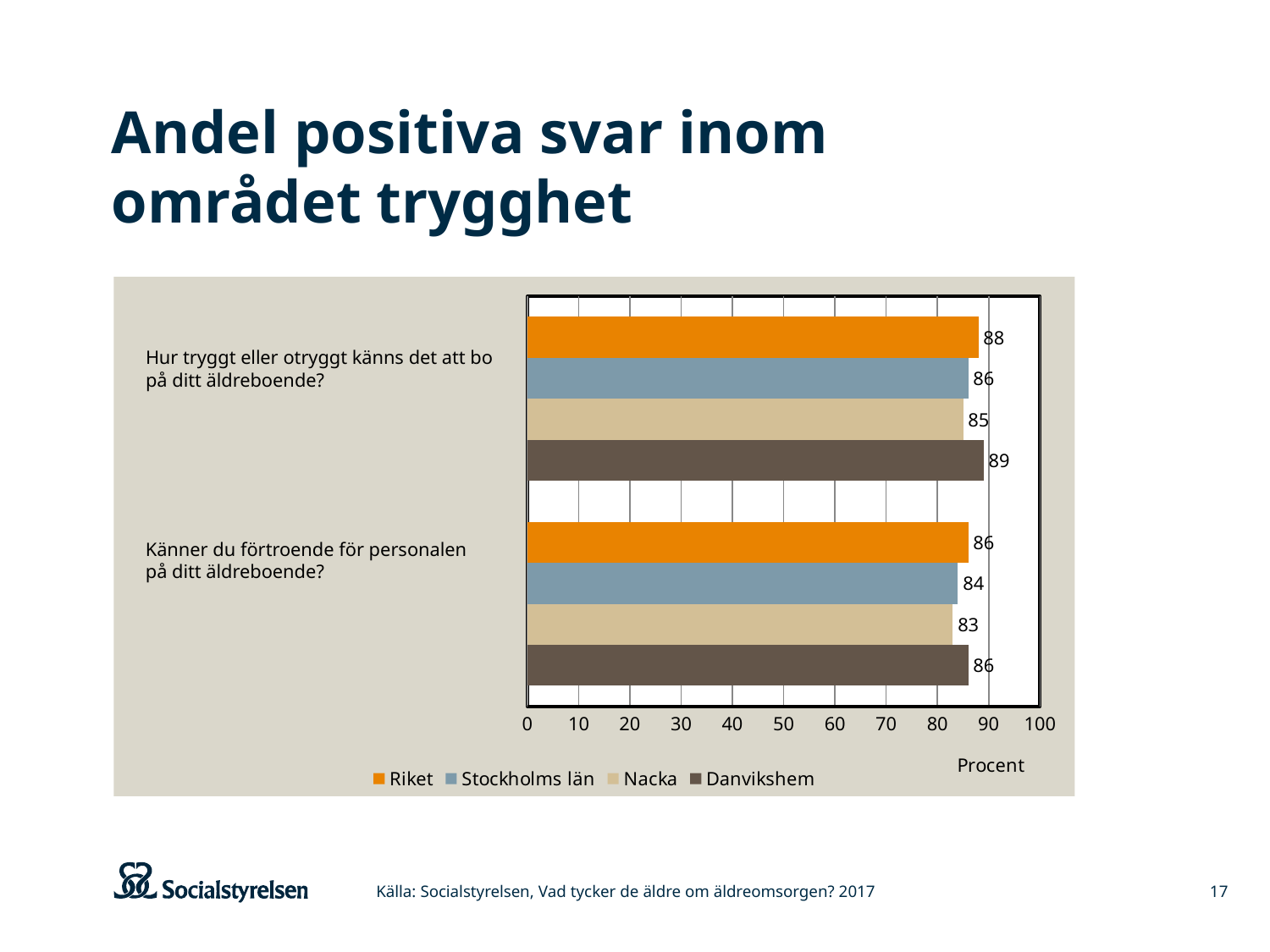
What kind of chart is shown on the slide? Bar chart What is the value for Danvikshem on the question "Känner du förtroende för personalen på ditt äldreboende?"? 86 Which is larger for "Känner du förtroende för personalen på ditt äldreboende?": Riket or Stockholms län? Riket What is the difference between the Danvikshem and Nacka values for "Hur tryggt eller otryggt känns det att bo på ditt äldreboende?"? 4 What unit is shown on the x axis of the chart? Procent What is the value for Nacka on the question "Känner du förtroende för personalen på ditt äldreboende?"? 83 How many series does the legend list? 4 Is the value for Stockholms län on "Känner du förtroende för personalen på ditt äldreboende?" greater or less than 90? less Which series has the lowest value for "Känner du förtroende för personalen på ditt äldreboende?"? Nacka Which series has the highest value for "Hur tryggt eller otryggt känns det att bo på ditt äldreboende?"? Danvikshem How many questions (categories) are shown in the chart? 2 What is the value for Riket on the question "Hur tryggt eller otryggt känns det att bo på ditt äldreboende?"? 88